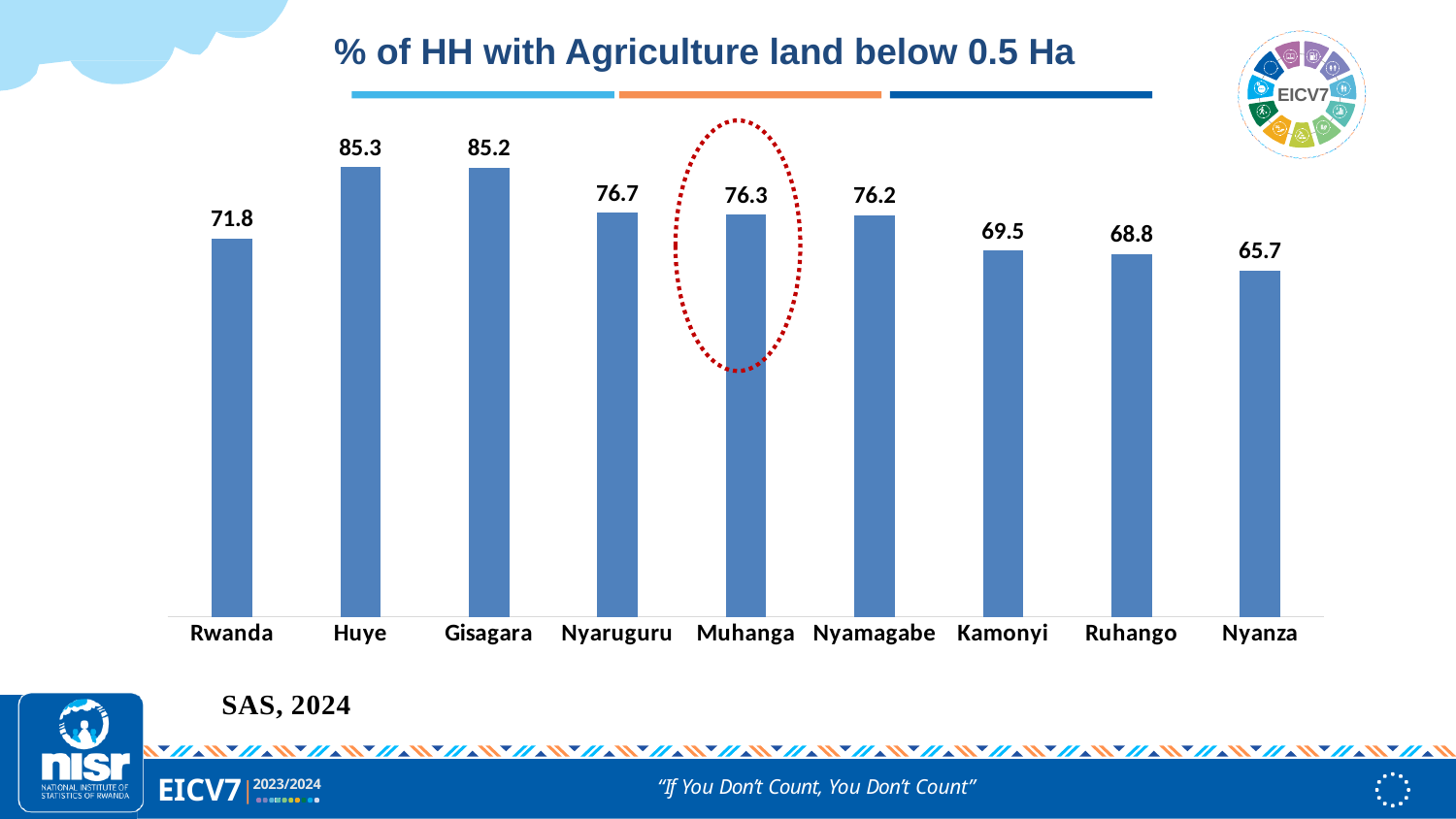
What is the value for Kamonyi? 69.5 How many categories are shown on the x axis? 9 What is the value for Rwanda? 71.8 Which category's bar is highlighted with a red dotted circle? Muhanga What is the value for Nyaruguru? 76.7 What is the value for Muhanga? 76.3 What is the difference between the values for Huye and Nyanza? 19.6 What kind of chart is shown on the slide? Bar chart Which district has the lowest percentage of households with agriculture land below 0.5 Ha? Nyanza Which is larger, the value for Rwanda or the value for Kamonyi? Rwanda What is the difference between the values for Rwanda and Nyanza? 6.1 Which is larger, the value for Nyaruguru or the value for Ruhango? Nyaruguru